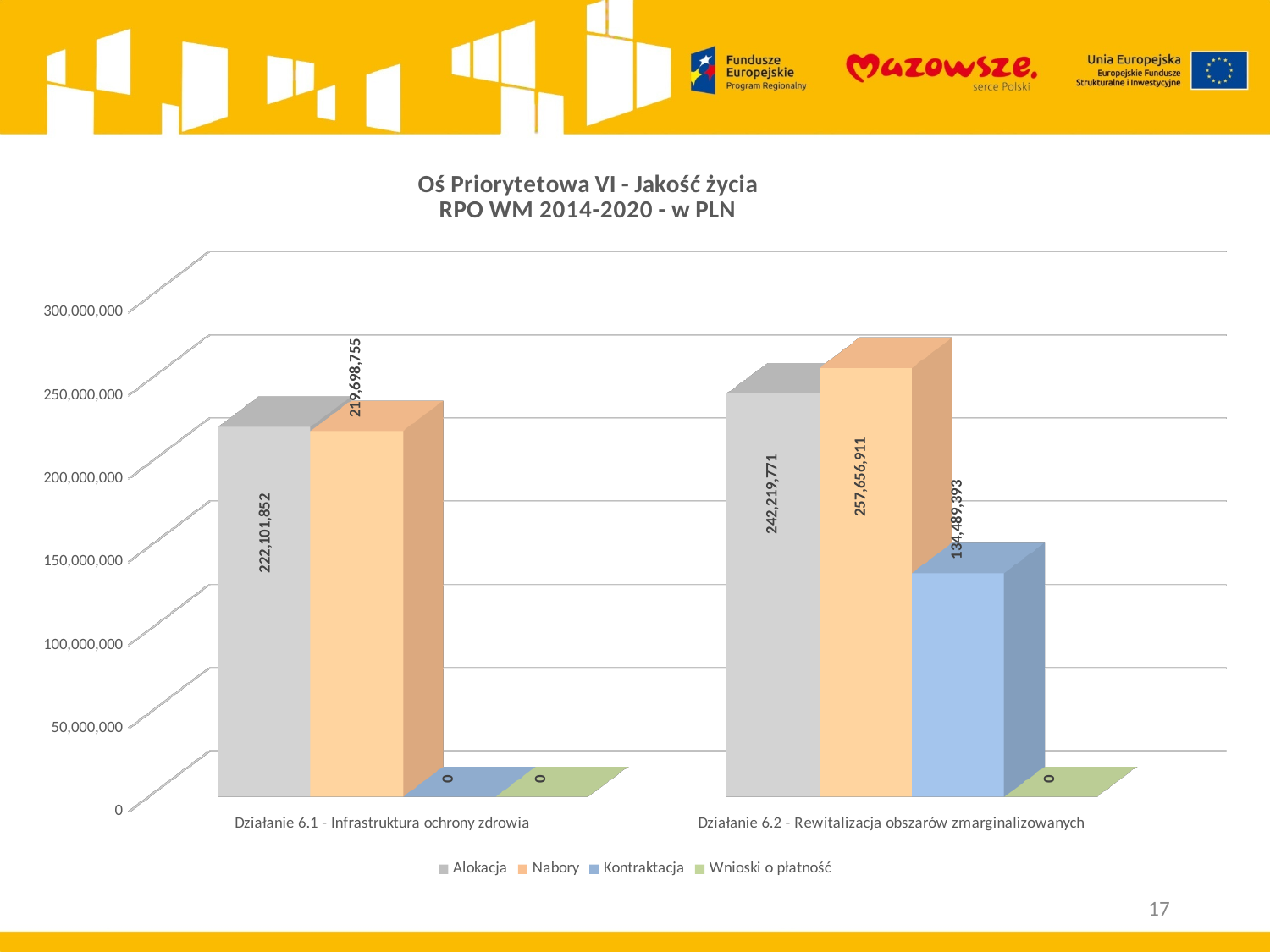
What is the Kontraktacja value for Działanie 6.2 - Rewitalizacja obszarów zmarginalizowanych? 134,489,393 What is the Wnioski o płatność value for Działanie 6.1 - Infrastruktura ochrony zdrowia? 0 Which is larger: the Alokacja value for Działanie 6.1 or the Alokacja value for Działanie 6.2? Działanie 6.2 How many categories are shown on the x axis? 2 What is the difference between the Nabory and Alokacja values for Działanie 6.2 - Rewitalizacja obszarów zmarginalizowanych? 15,437,140 What is the Nabory value for Działanie 6.2 - Rewitalizacja obszarów zmarginalizowanych? 257,656,911 How many series does the legend list? 4 What is the difference between the Alokacja values for Działanie 6.2 and Działanie 6.1? 20,117,919 What is the title of the chart? Oś Priorytetowa VI - Jakość życia RPO WM 2014-2020 - w PLN Which series has the highest value for Działanie 6.2 - Rewitalizacja obszarów zmarginalizowanych? Nabory What kind of chart is shown on the slide? Bar chart What is the Alokacja value for Działanie 6.1 - Infrastruktura ochrony zdrowia? 222,101,852